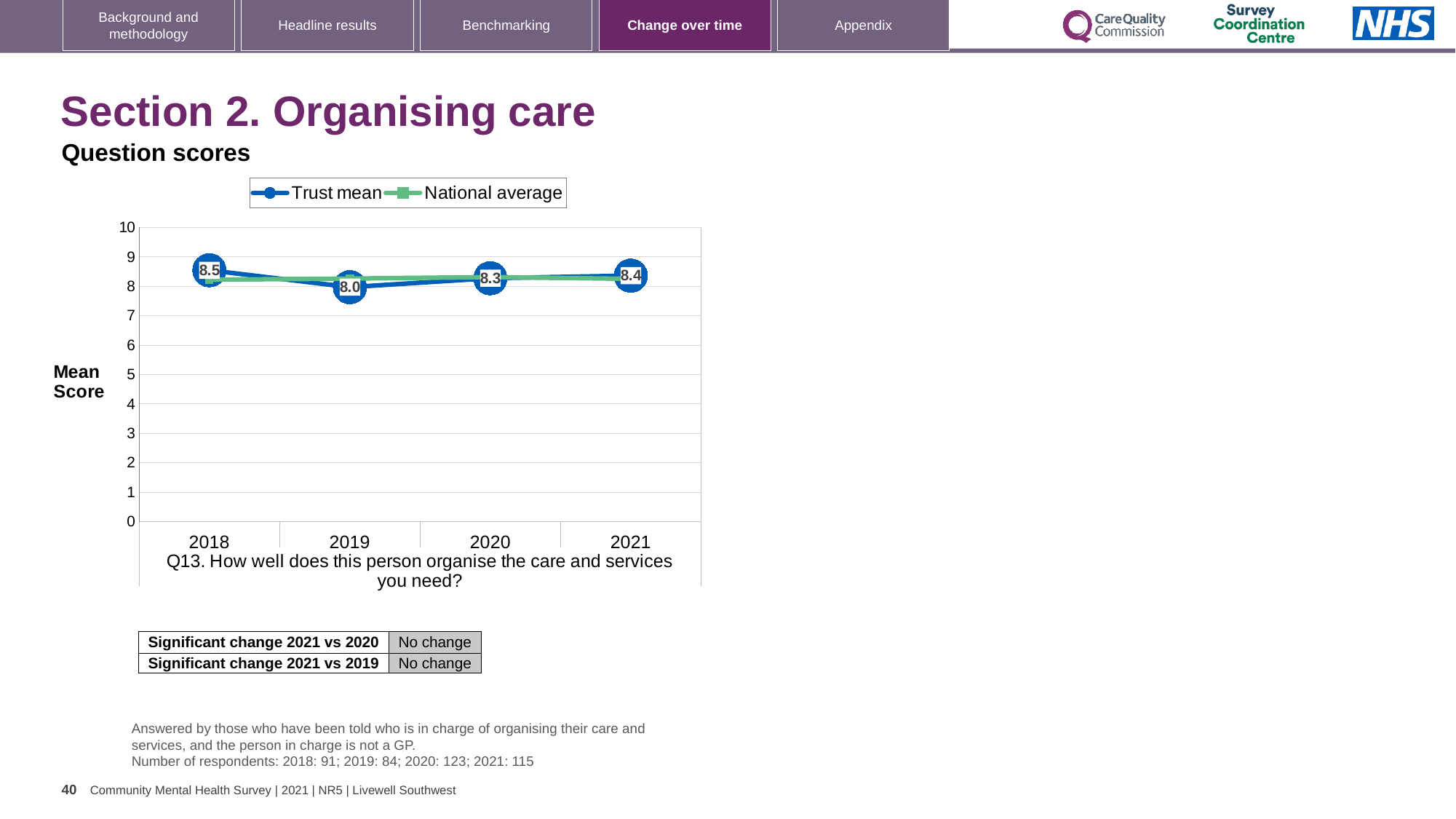
What is the Trust mean for 2021? 8.4 Which year has the larger Trust mean, 2020 or 2021? 2021 What is the Trust mean for 2019? 8.0 What kind of chart is shown? Line chart What is the difference between the Trust mean in 2018 and in 2019? 0.5 What is the Trust mean for 2018? 8.5 In which year is the Trust mean lowest? 2019 Does the Trust mean rise or fall from 2019 to 2021? Rise How many years are plotted on the x axis? 4 How many series does the legend list? 2 Is the National average for 2020 greater or less than 5? greater In which year is the Trust mean highest? 2018